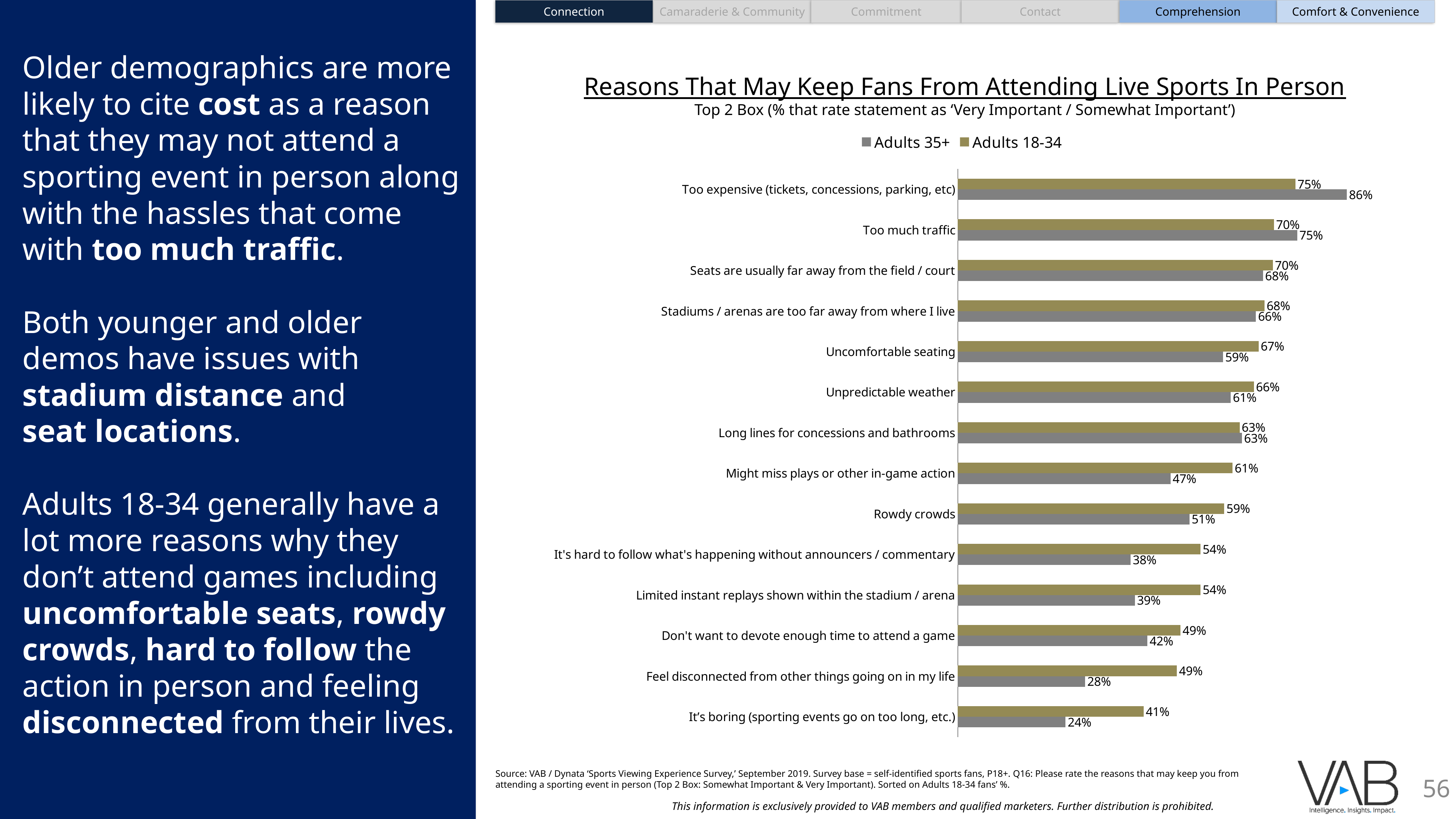
Which reason has the highest value for Adults 18-34? Too expensive (tickets, concessions, parking, etc) What percentage of Adults 35+ rate 'Too expensive (tickets, concessions, parking, etc)' as important? 86% Which reason has the lowest value for Adults 35+? It's boring (sporting events go on too long, etc.) For 'Uncomfortable seating', which group has the higher value, Adults 18-34 or Adults 35+? Adults 18-34 How many reasons are listed in the chart? 14 What is the difference between Adults 35+ and Adults 18-34 for 'Too expensive (tickets, concessions, parking, etc)'? 11 percentage points What type of chart is shown on the slide? Bar chart What is the difference between Adults 18-34 and Adults 35+ for 'It's hard to follow what's happening without announcers / commentary'? 16 percentage points What percentage of Adults 18-34 rate 'Rowdy crowds' as important? 59% What is the value for Adults 35+ for 'Feel disconnected from other things going on in my life'? 28% For 'Too much traffic', which group has the higher value, Adults 18-34 or Adults 35+? Adults 35+ How many series does the legend list? 2